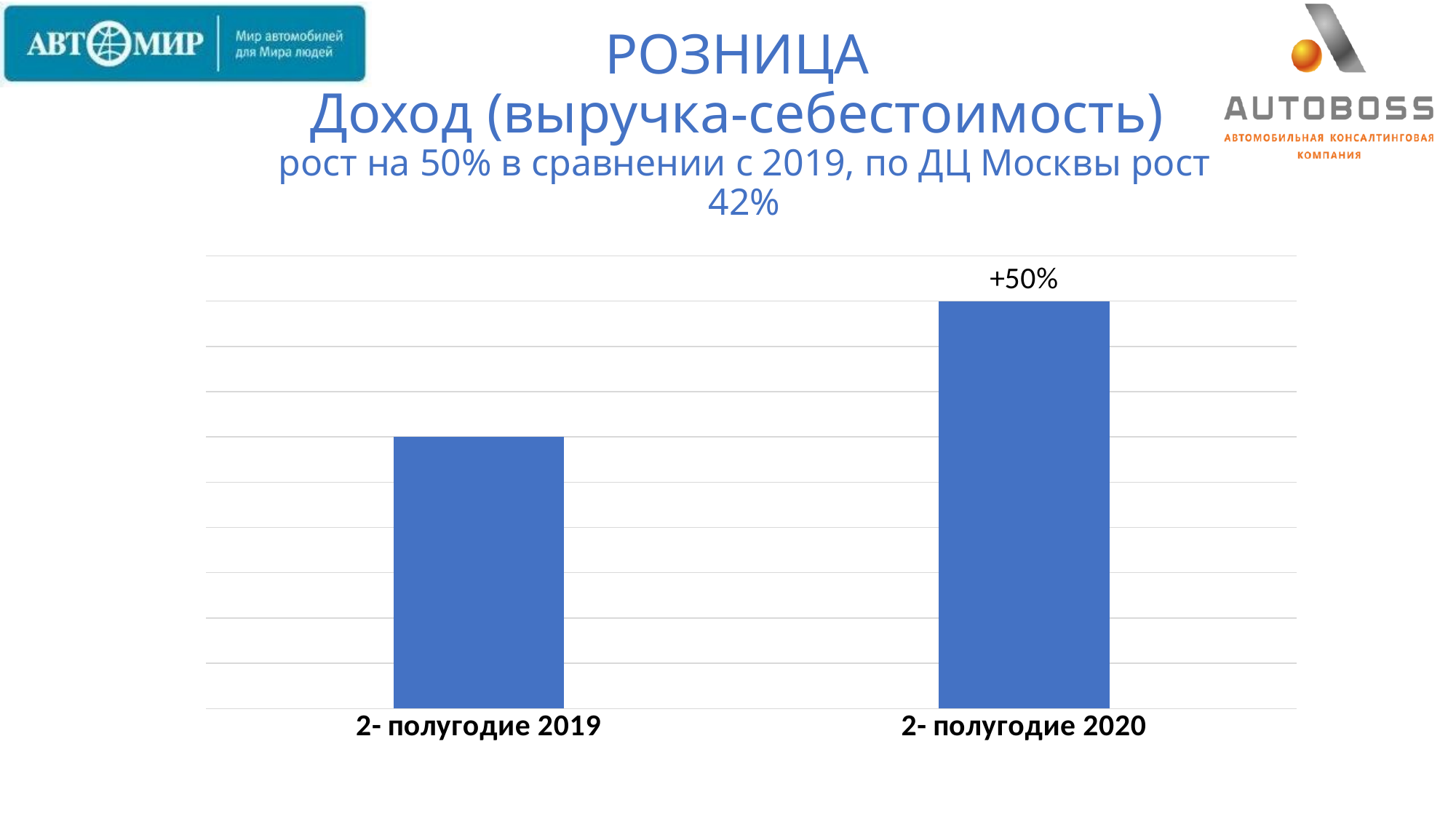
Do the values rise or fall from 2- полугодие 2019 to 2- полугодие 2020? rise Which category has the highest bar? 2- полугодие 2020 How many bars (categories) does the chart show? 2 What is the label of the first (left) category on the x axis? 2- полугодие 2019 What data label is printed above the bar for 2- полугодие 2020? +50% Which bar is taller: 2- полугодие 2019 or 2- полугодие 2020? 2- полугодие 2020 What kind of chart is shown on the slide? bar chart Which category has the lowest bar? 2- полугодие 2019 What colour are the bars in the chart? blue